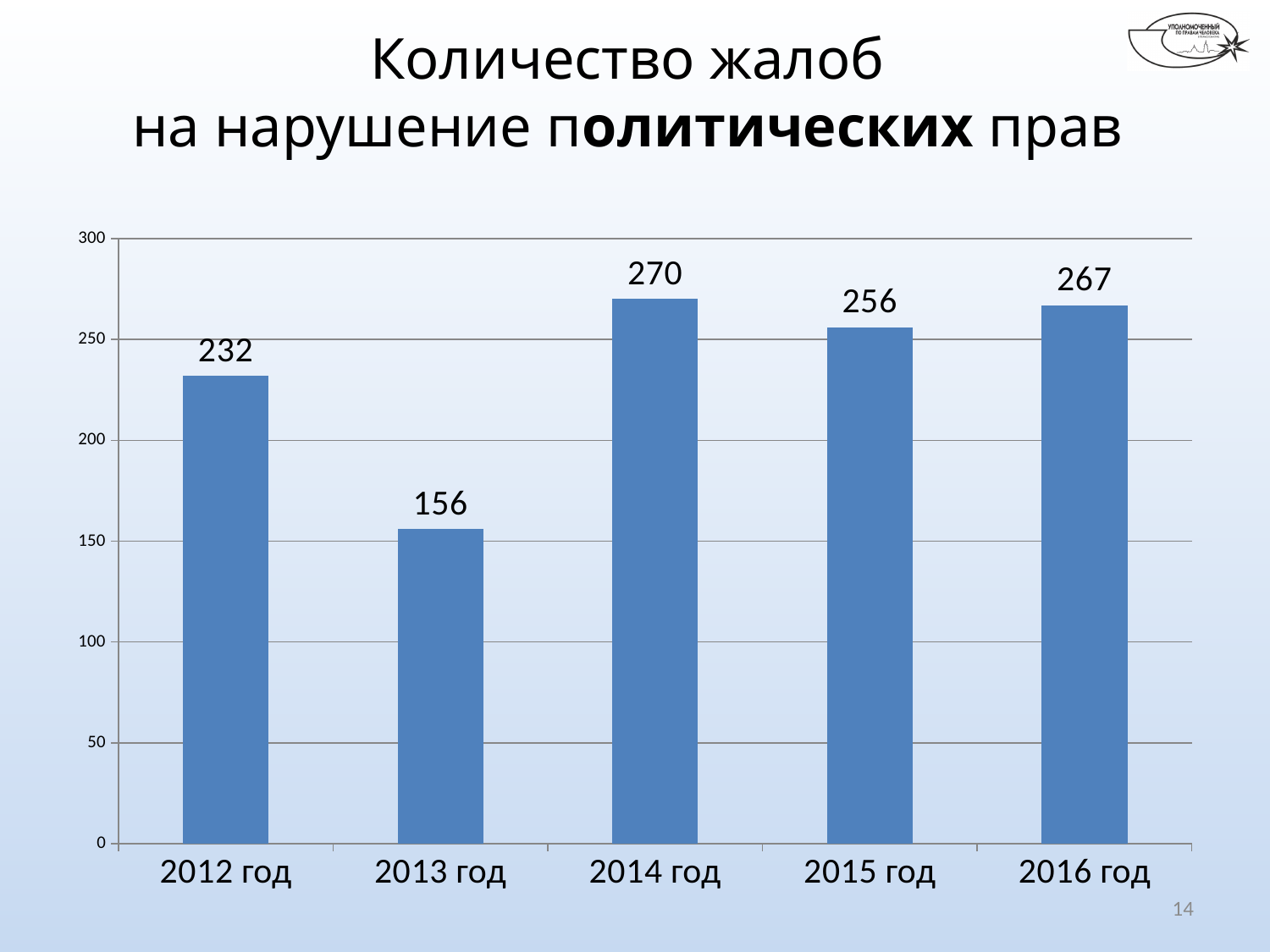
What is the difference between the values for 2014 год and 2013 год? 114 Which year has the lowest number of complaints? 2013 год Which year has the highest number of complaints? 2014 год What kind of chart is shown on the slide? bar chart Which is larger, the value for 2012 год or the value for 2015 год? 2015 год What is the title of the slide? Количество жалоб на нарушение политических прав What is the difference between the values for 2016 год and 2015 год? 11 How many years are shown on the x axis? 5 Is the value for 2012 год greater or less than 250? less What is the number of complaints for 2013 год? 156 What is the number of complaints for 2014 год? 270 What is the value shown for 2016 год? 267